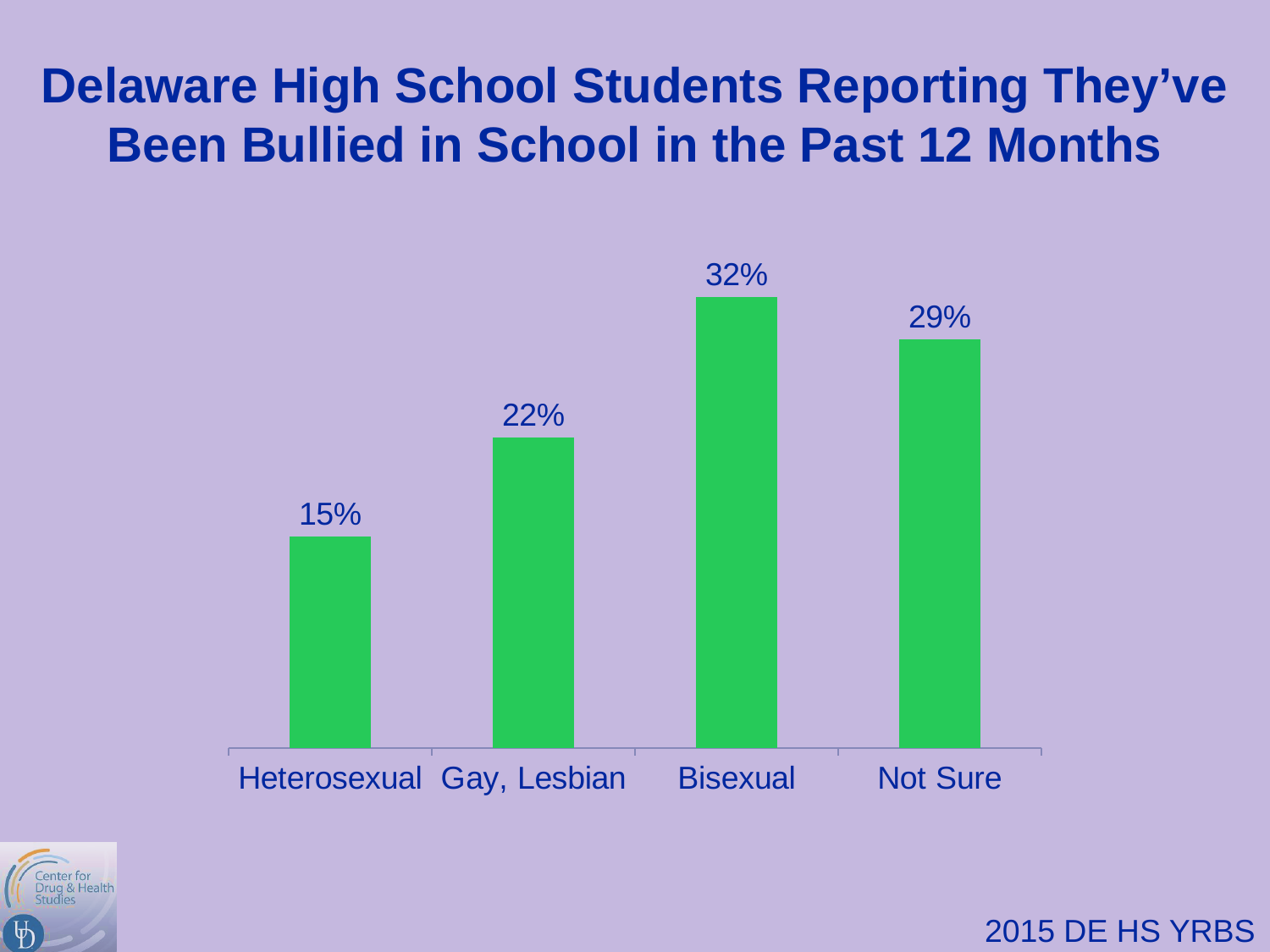
Which category has the highest percentage of students reporting being bullied? Bisexual Which category has the lowest percentage of students reporting being bullied? Heterosexual How many categories are shown on the chart? 4 What is the difference between the Bisexual and Heterosexual percentages? 17% What kind of chart is shown on the slide? Bar chart What is the value shown for the Gay, Lesbian category? 22% What percentage of Heterosexual students reported being bullied in school in the past 12 months? 15% What is the value for the Not Sure category? 29% What percentage is shown for Bisexual students? 32% What is the difference between the Not Sure and Gay, Lesbian percentages? 7% What data source is cited at the bottom of the slide? 2015 DE HS YRBS Which is larger, the value for Not Sure or the value for Gay, Lesbian? Not Sure